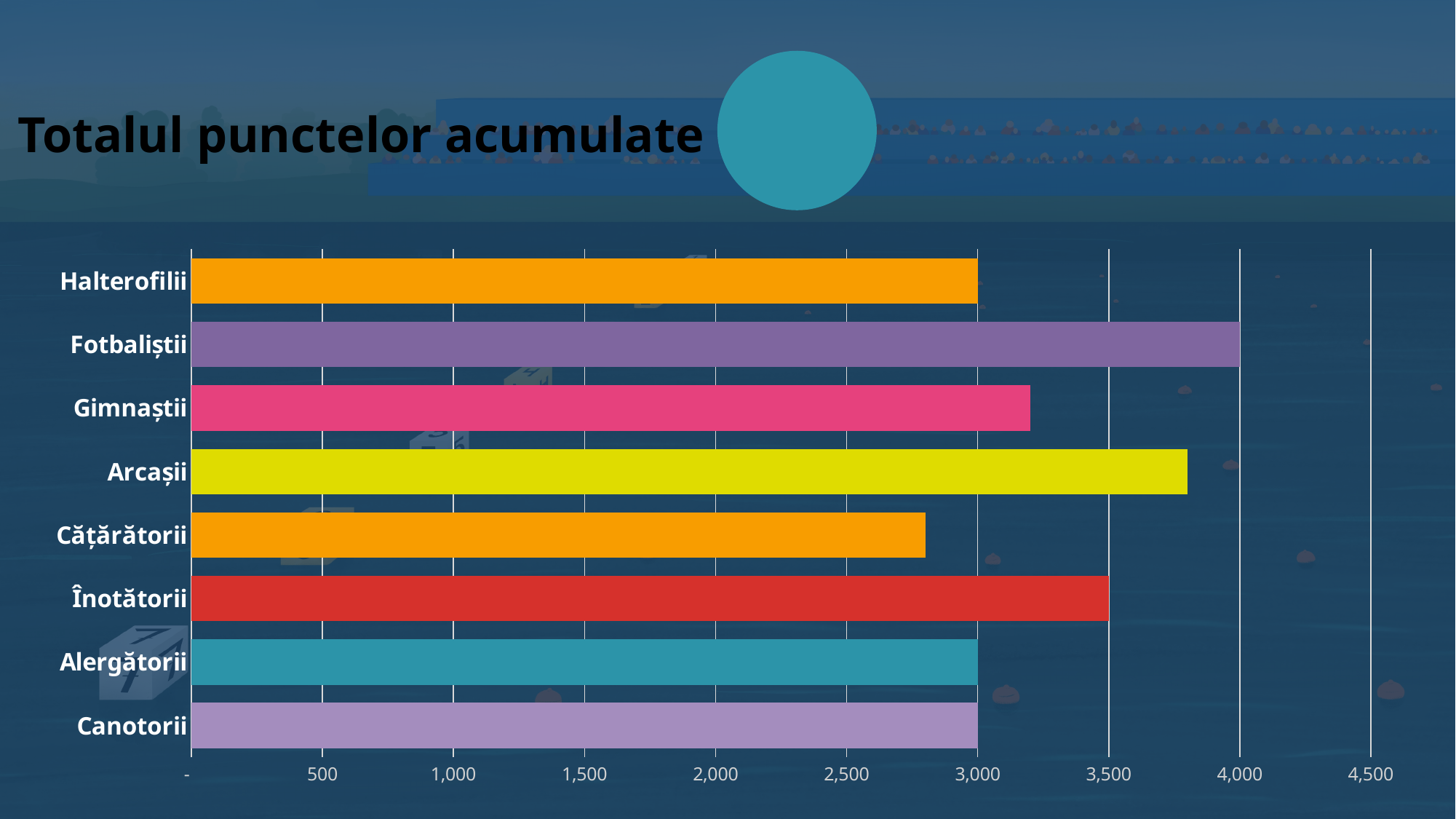
Which is larger, the value for Arcașii or the value for Gimnaștii? Arcașii What is the value for Înotătorii? 3,500 What is the difference between the values for Fotbaliștii and Înotătorii? 500 Is the value for Gimnaștii greater or less than 3,000? greater Which category has the highest value? Fotbaliștii How many categories are shown in the chart? 8 What is the title of the chart? Totalul punctelor acumulate Which category has the lowest value? Cățărătorii What kind of chart is shown on the slide? bar chart Is the value for Arcașii greater or less than 4,000? less What is the value for Canotorii? 3,000 What is the value for Fotbaliștii? 4,000